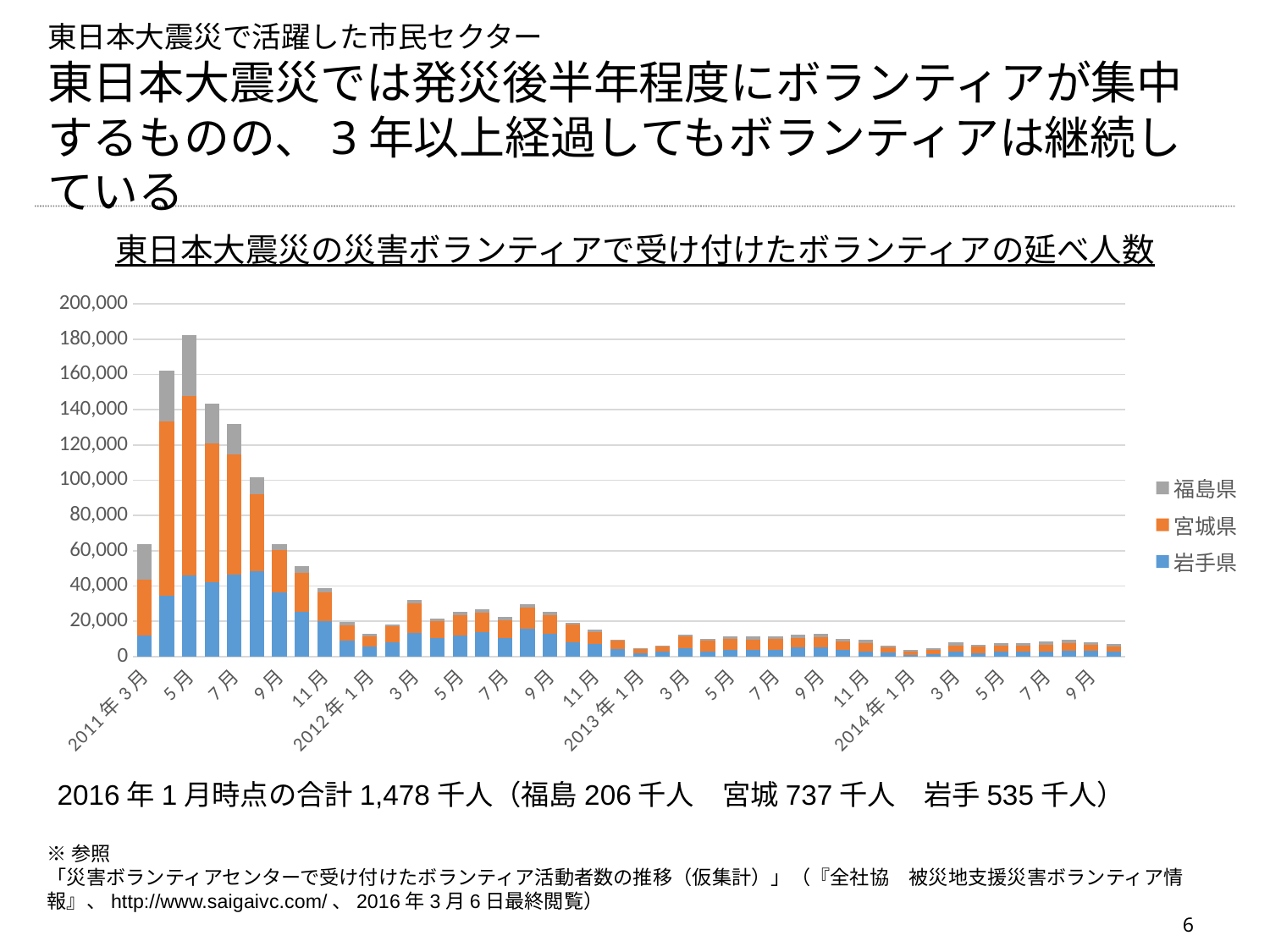
What kind of chart is shown on the slide? Stacked bar chart How many series does the legend list? 3 Is the total value for 2011年7月 greater or less than 100,000? greater Which month has the highest total bar? 2011年5月 Is the total value for 2011年3月 greater or less than 80,000? less Which has the larger total bar, 2011年5月 or 2011年7月? 2011年5月 What is the title of the chart? 東日本大震災の災害ボランティアで受け付けたボランティアの延べ人数 Is the total value for 2012年1月 greater or less than 40,000? less Do the total values rise or fall from 2011年5月 to 2011年11月? fall What are the three series listed in the legend? 福島県, 宮城県, 岩手県